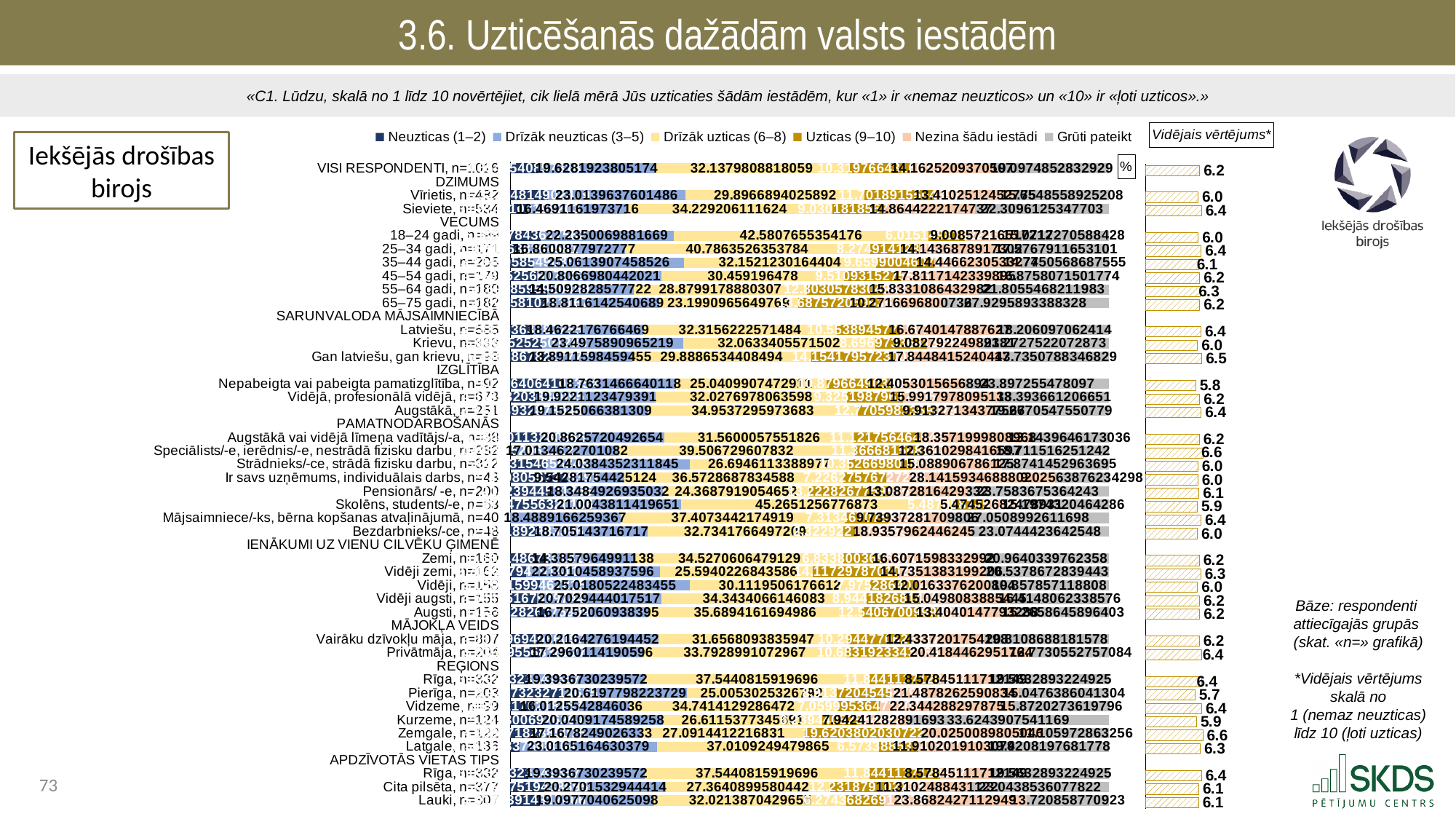
Among the REĢIONS groups, which has the lowest average rating? Pierīga What is the difference between the average ratings of Sieviete and Vīrietis? 0.4 Which legend entry represents the rating 9–10? Uzticas (9–10) Which has a higher average rating, Latviešu or Krievu? Latviešu What kind of chart is used to show the distribution of responses? Stacked bar chart What is the average rating shown for Speciālists/-e, ierēdnis/-e, nestrādā fizisku darbu? 6.6 What is the average rating (Vidējais vērtējums) for VISI RESPONDENTI? 6.2 What is the average rating shown for Sieviete? 6.4 How many series does the legend list? 6 What is the average rating shown for Pierīga? 5.7 Among the REĢIONS groups, which has the highest average rating? Zemgale Among the IZGLĪTĪBA groups, which has the lowest average rating? Nepabeigta vai pabeigta pamatizglītība